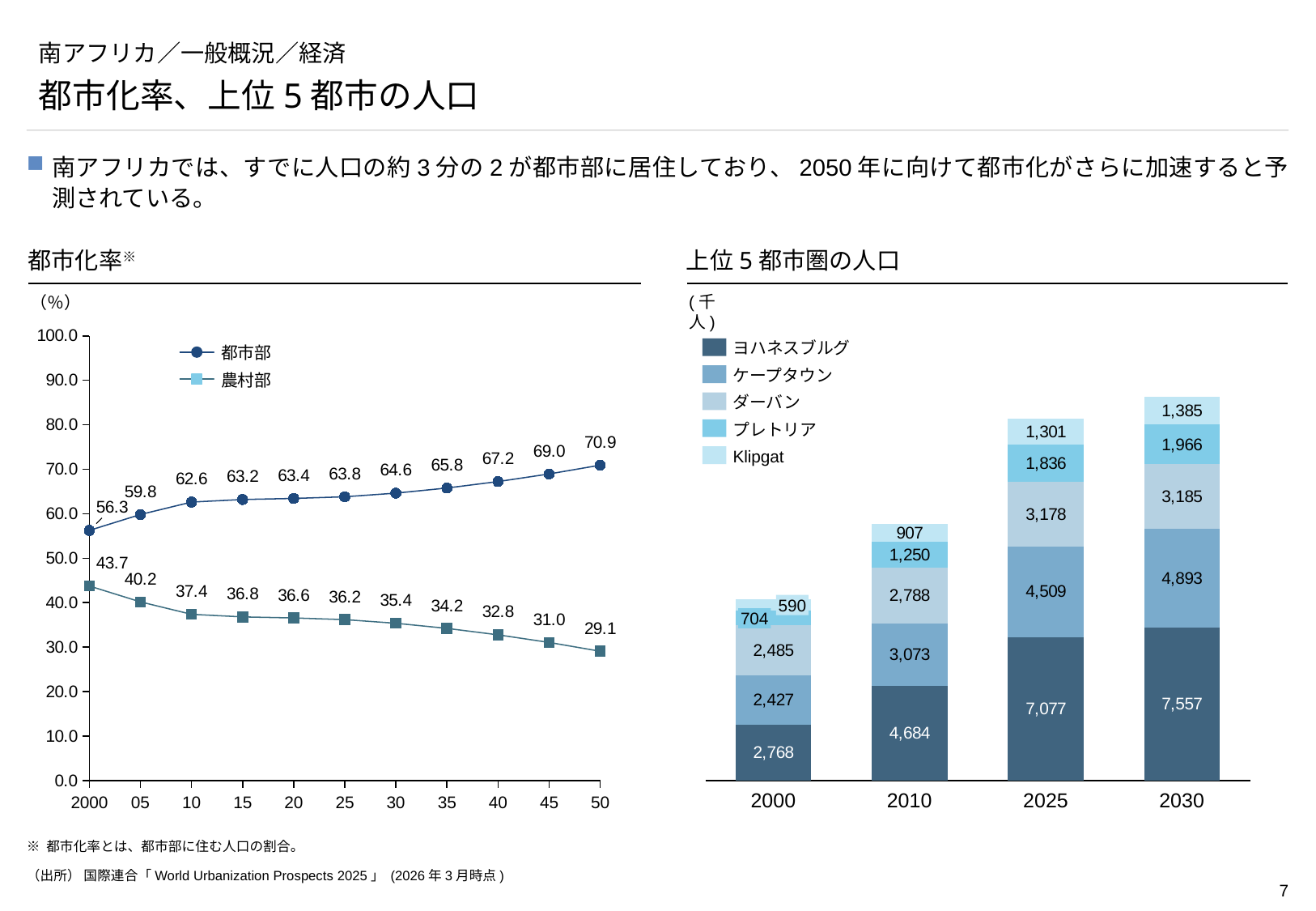
In the 都市化率 chart, what is the difference between the 都市部 values for 2050 and 2000? 14.6 In the 都市化率 chart, what kind of chart is it? line chart In the 都市化率 chart, does the 農村部 series rise or fall from 2000 to 2050? fall In the 上位5都市圏の人口 chart, what is the value for ヨハネスブルグ in 2010? 4,684 In the 上位5都市圏の人口 chart, which is larger, ケープタウン in 2000 or ダーバン in 2000? ダーバン In the 都市化率 chart, how many series does the legend list? 2 In the 都市化率 chart, what is the value for 農村部 in 2000? 43.7 In the 上位5都市圏の人口 chart, what is the value for プレトリア in 2025? 1,836 In the 上位5都市圏の人口 chart, what is the total of the stacked bar for 2030? 18,986 In the 都市化率 chart, what is the value for 都市部 in 2050? 70.9 In the 上位5都市圏の人口 chart, how many series does the legend list? 5 In the 上位5都市圏の人口 chart, how many years are shown on the x axis? 4